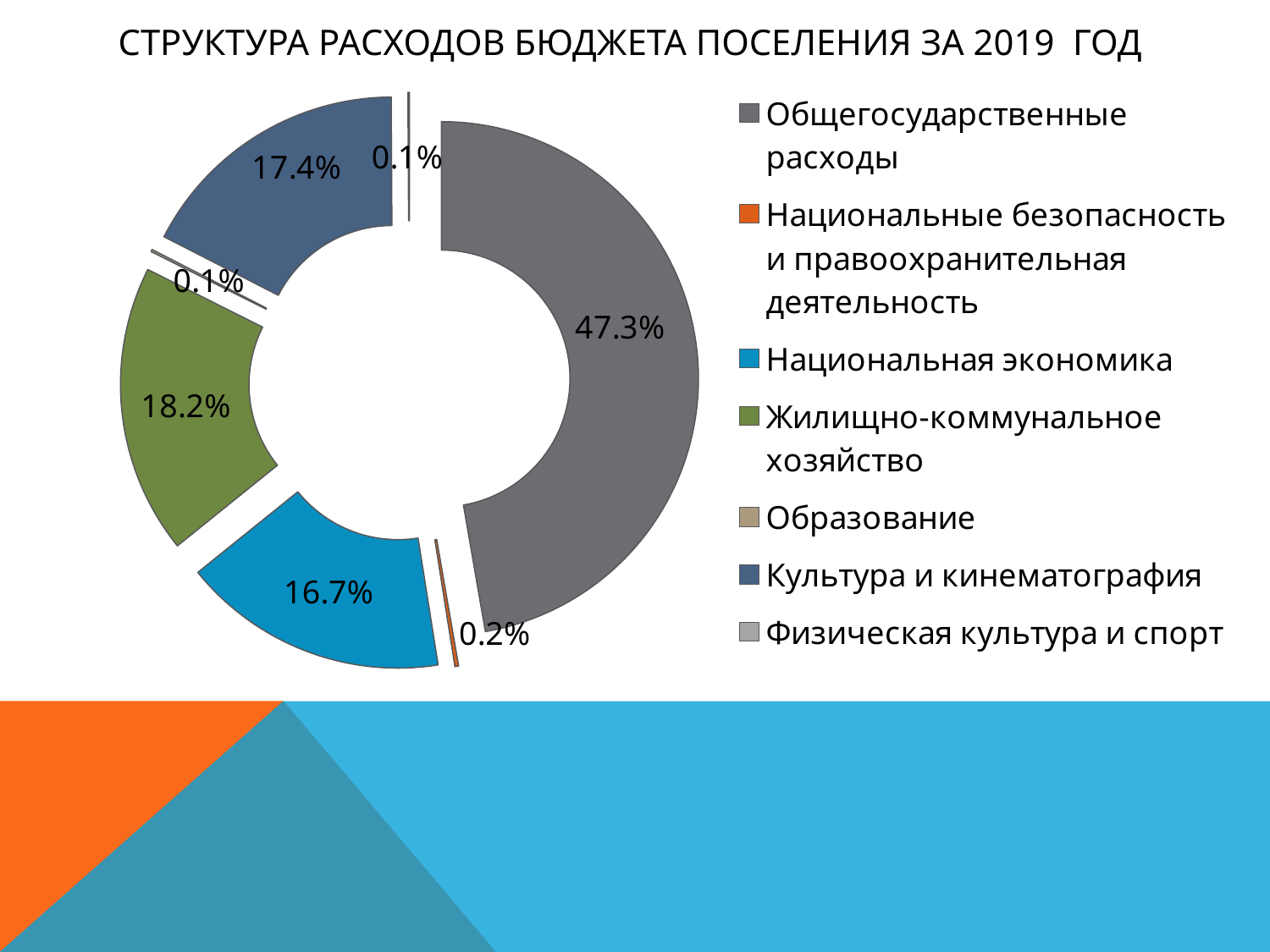
What share of the budget expenditure goes to Общегосударственные расходы? 47.3% Which is larger: the share for Жилищно-коммунальное хозяйство or for Национальная экономика? Жилищно-коммунальное хозяйство Which category has the largest share of the budget expenditure? Общегосударственные расходы How many categories does the legend list? 7 What is the difference between the shares for Общегосударственные расходы and Жилищно-коммунальное хозяйство? 29.1% What type of chart is shown on the slide? Doughnut chart What share is shown for Жилищно-коммунальное хозяйство? 18.2% What share is shown for Национальная экономика? 16.7% What is the title of the chart? СТРУКТУРА РАСХОДОВ БЮДЖЕТА ПОСЕЛЕНИЯ ЗА 2019 ГОД What is the difference between the shares for Культура и кинематография and Национальная экономика? 0.7% What share is shown for Национальные безопасность и правоохранительная деятельность? 0.2% What share is shown for Культура и кинематография? 17.4%